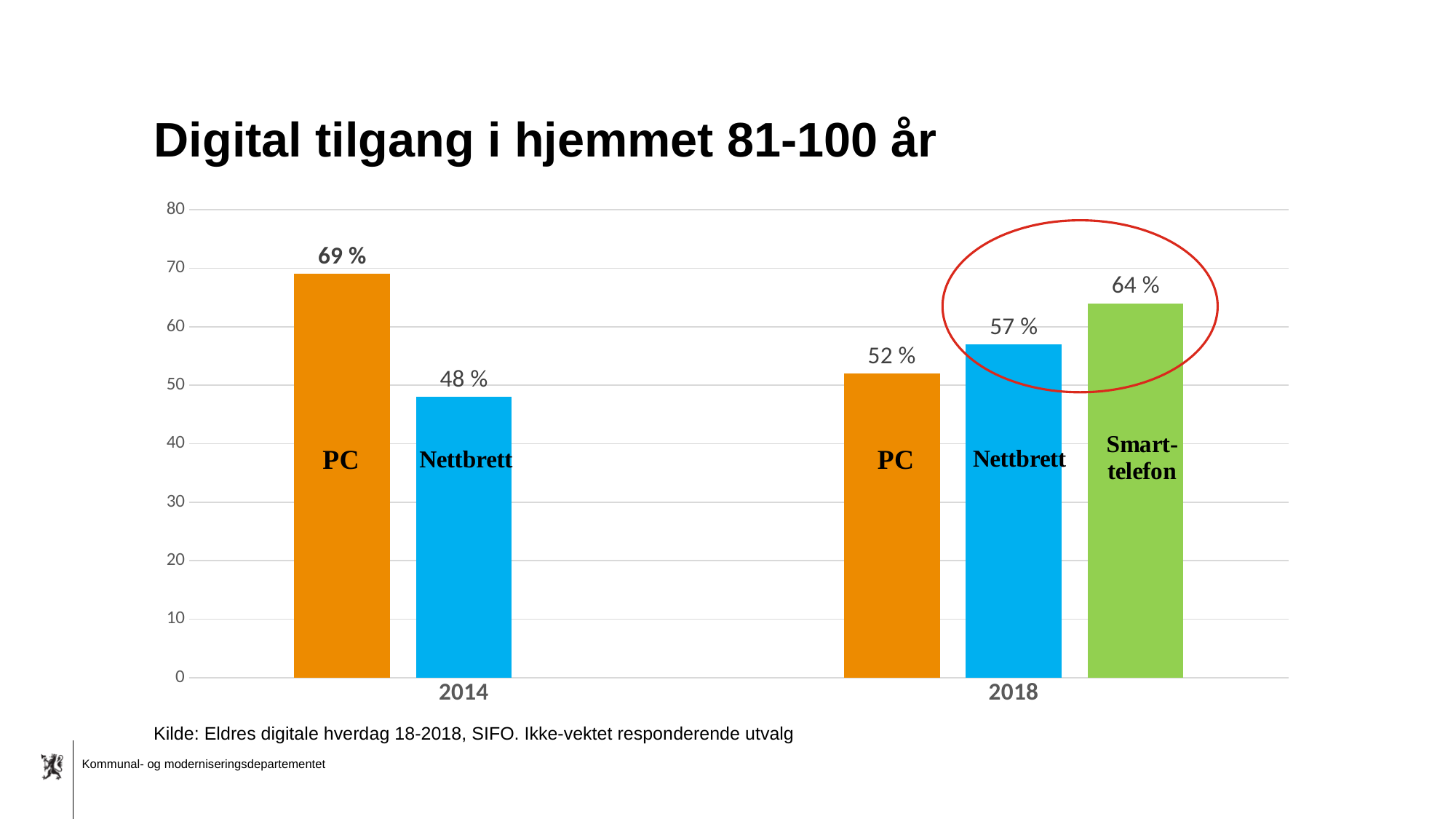
What is the value for Smarttelefon in 2018? 64 % What kind of chart is shown on the slide? Bar chart How many bars are shown for 2018? 3 Which bar has the lowest value on the chart? Nettbrett in 2014 Did the value for Nettbrett rise or fall from 2014 to 2018? Rise What is the value for PC in 2014? 69 % What is the value for PC in 2018? 52 % Which is larger in 2018, Nettbrett or Smarttelefon? Smarttelefon Which bar has the highest value on the chart? PC in 2014 What is the difference between the PC value in 2014 and the PC value in 2018? 17 % What is the value for Nettbrett in 2018? 57 % What is the title of the chart? Digital tilgang i hjemmet 81-100 år